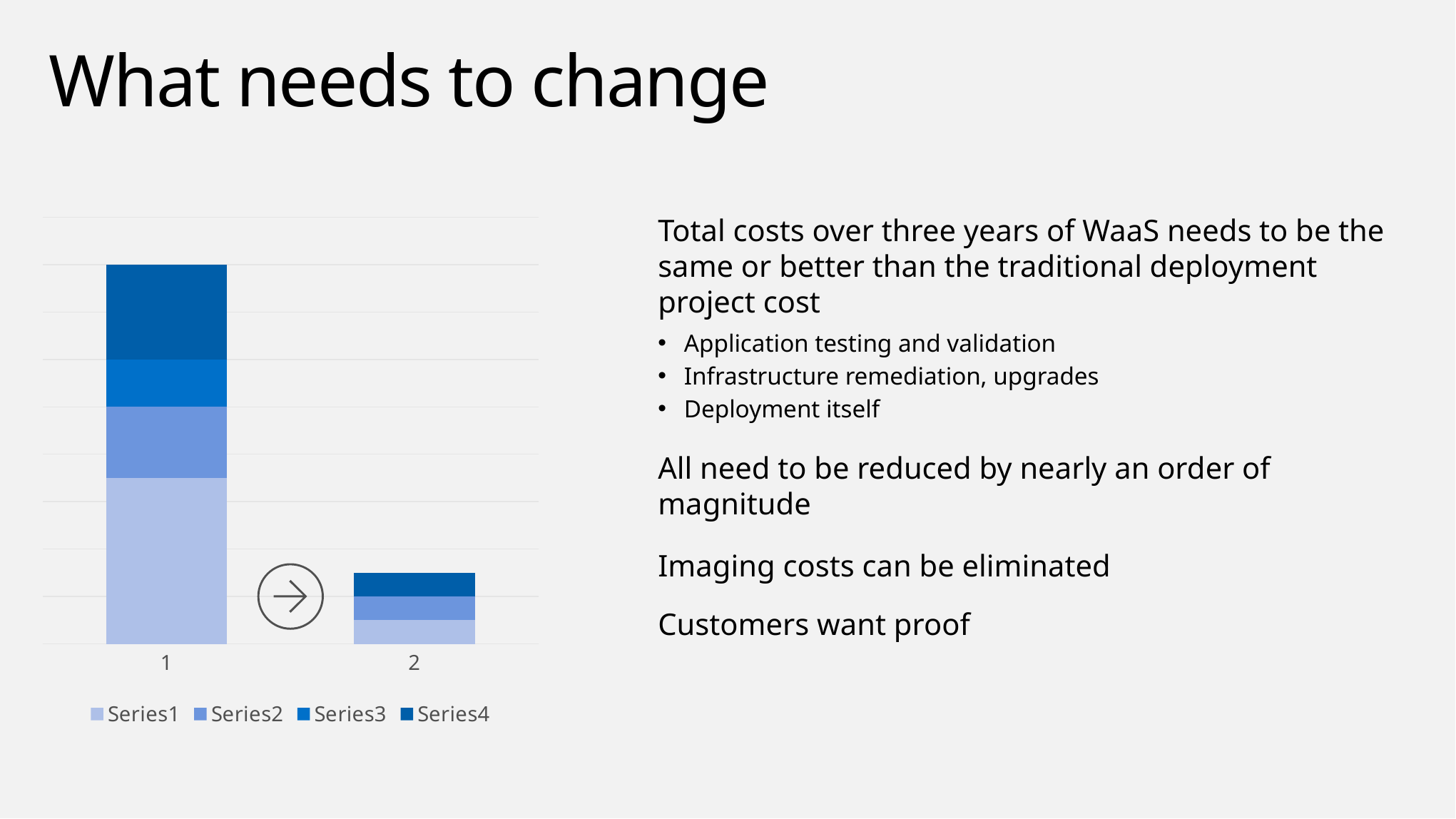
Do the stacked bar totals rise or fall from category 1 to category 2? Fall Within category 1, which series occupies the largest segment of the bar? Series1 Which category has the taller stacked bar, 1 or 2? 1 What kind of chart is shown on the slide? Stacked bar chart Which series is listed first in the chart's legend? Series1 How many categories are shown on the x axis of the chart? 2 Is the Series1 segment in category 1 larger or smaller than the Series1 segment in category 2? Larger Which category has the shorter stacked bar? 2 Which series is listed last in the chart's legend? Series4 How many series does the chart's legend list? 4 Is the total bar for category 1 larger or smaller than the total bar for category 2? Larger